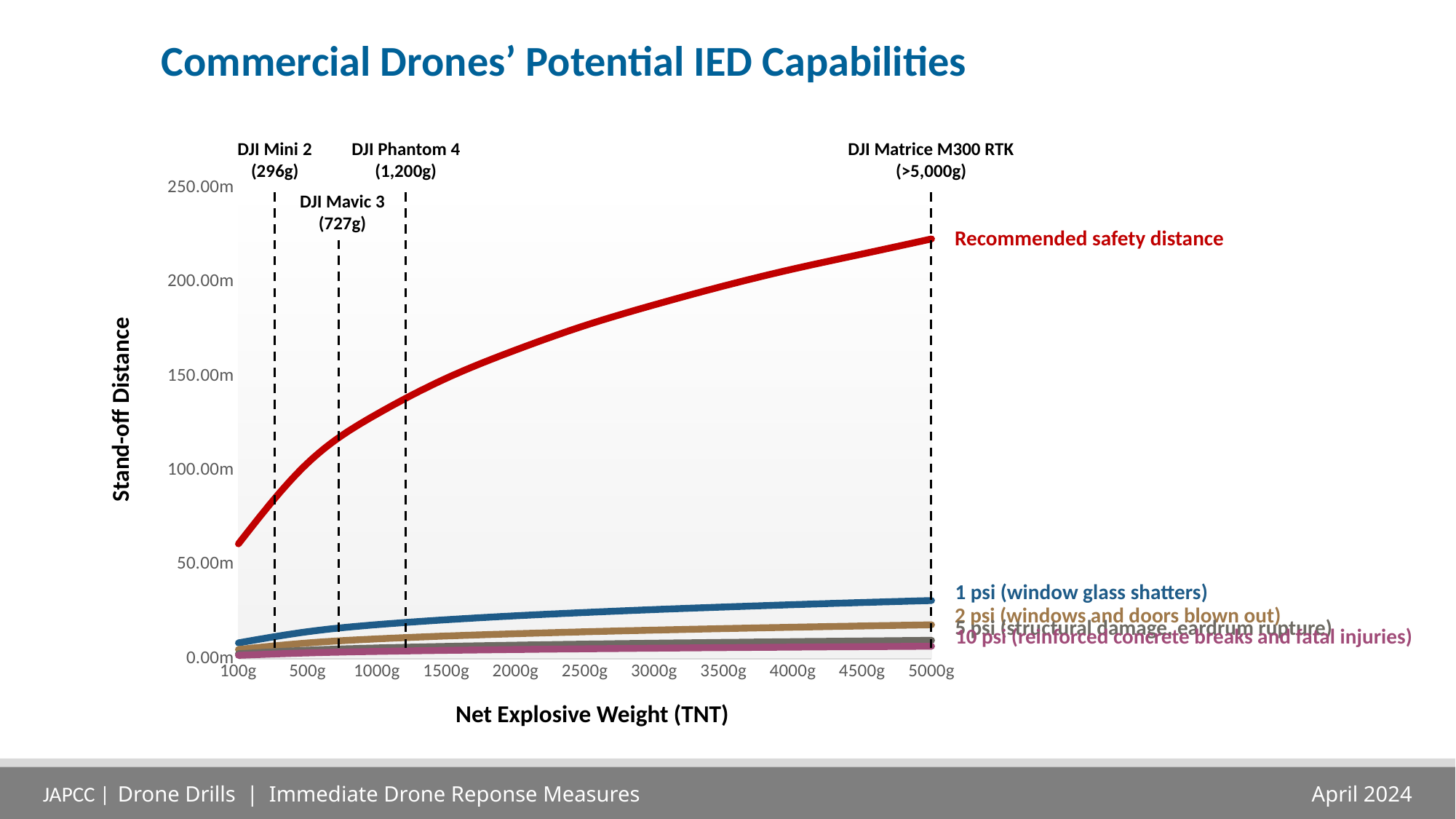
Is the Recommended safety distance at 100g greater or less than 50.00m? greater Is the Recommended safety distance at 5000g greater or less than 200.00m? greater What is the title of the chart on the slide? Commercial Drones' Potential IED Capabilities Which series has the highest stand-off distance across the chart? Recommended safety distance Is the Recommended safety distance at 1000g greater or less than 100.00m? greater Does the Recommended safety distance rise or fall as Net Explosive Weight increases? Rises Which series has the lowest stand-off distance across the chart? 10 psi (reinforced concrete breaks and fatal injuries) At 5000g, which is larger: the 1 psi (window glass shatters) distance or the 2 psi (windows and doors blown out) distance? 1 psi (window glass shatters) How many lines (series) are labelled on the chart? 5 What net explosive weight is marked for the DJI Phantom 4 on the chart? 1,200g What kind of chart is shown on the slide? Line chart